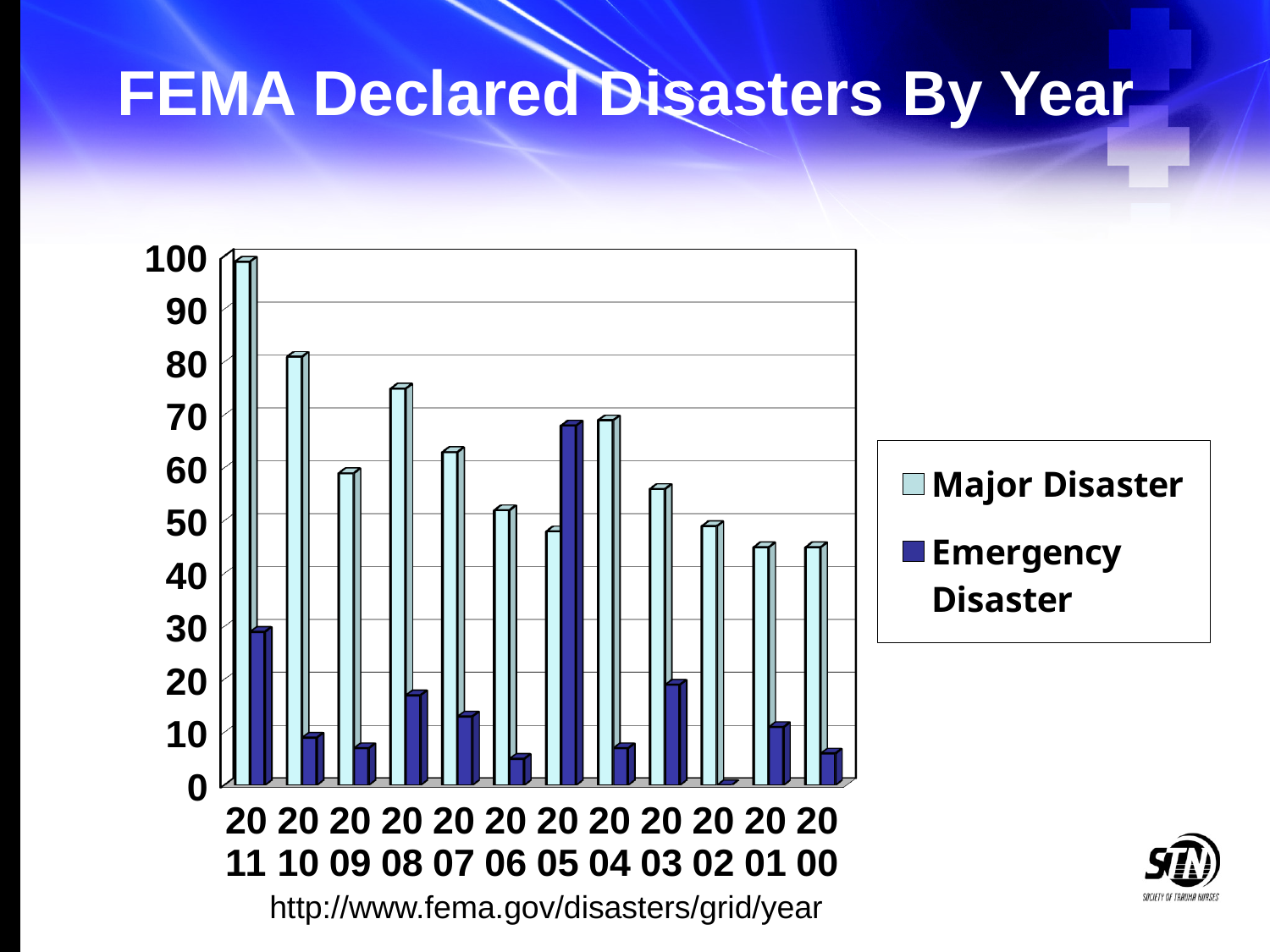
Which series is shown in dark blue in the legend? Emergency Disaster Which year has the larger Major Disaster value, 2008 or 2009? 2008 What kind of chart is shown on the slide? bar chart How many series does the legend list? 2 Which year has the lowest Emergency Disaster value? 2002 Is the Major Disaster value for 2011 greater or less than 90? greater Which year has the larger Emergency Disaster value, 2003 or 2004? 2003 Is the Emergency Disaster value for 2005 greater or less than 60? greater Is the Major Disaster value for 2005 greater or less than 50? less Which year has the highest Major Disaster value? 2011 Which year has the highest Emergency Disaster value? 2005 How many years are shown on the x axis? 12